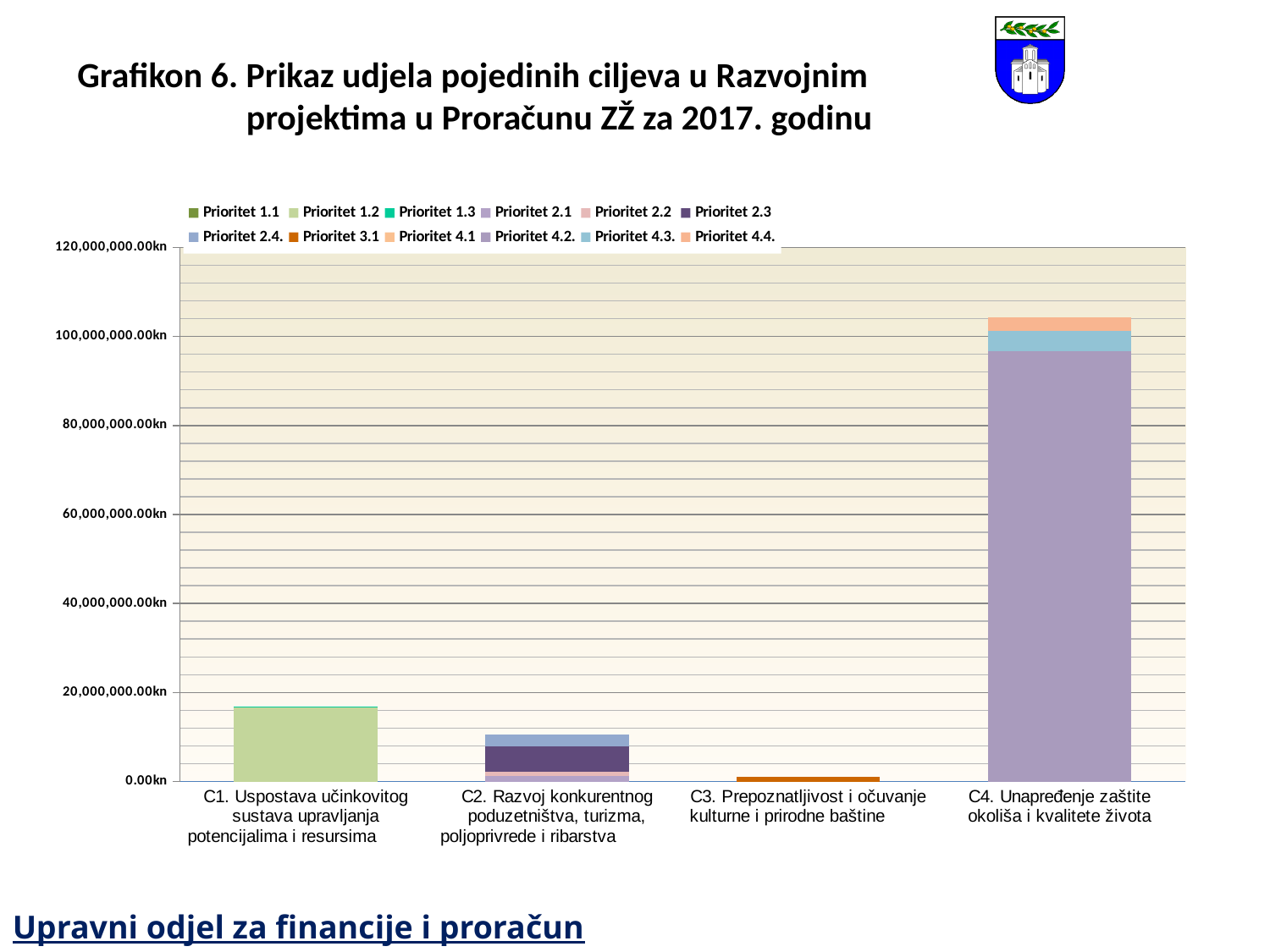
Which category has the shortest stacked bar? C3. Prepoznatljivost i očuvanje kulturne i prirodne baštine Which has the larger total bar: C2. Razvoj konkurentnog poduzetništva, turizma, poljoprivrede i ribarstva or C3. Prepoznatljivost i očuvanje kulturne i prirodne baštine? C2. Razvoj konkurentnog poduzetništva, turizma, poljoprivrede i ribarstva Is the total value for C2. Razvoj konkurentnog poduzetništva, turizma, poljoprivrede i ribarstva greater or less than 20,000,000.00kn? less What is the title of the chart on the slide? Grafikon 6. Prikaz udjela pojedinih ciljeva u Razvojnim projektima u Proračunu ZŽ za 2017. godinu How many series does the chart's legend list? 12 Is the total value for C4. Unapređenje zaštite okoliša i kvalitete života greater or less than 100,000,000.00kn? greater What kind of chart is shown on the slide? Stacked bar chart What is the highest value shown on the chart's y axis? 120,000,000.00kn Which category has the tallest stacked bar? C4. Unapređenje zaštite okoliša i kvalitete života How many categories (ciljevi) are shown on the x axis of the chart? 4 Is the total value for C1. Uspostava učinkovitog sustava upravljanja potencijalima i resursima greater or less than 20,000,000.00kn? less Which has the larger total bar: C1. Uspostava učinkovitog sustava upravljanja potencijalima i resursima or C2. Razvoj konkurentnog poduzetništva, turizma, poljoprivrede i ribarstva? C1. Uspostava učinkovitog sustava upravljanja potencijalima i resursima